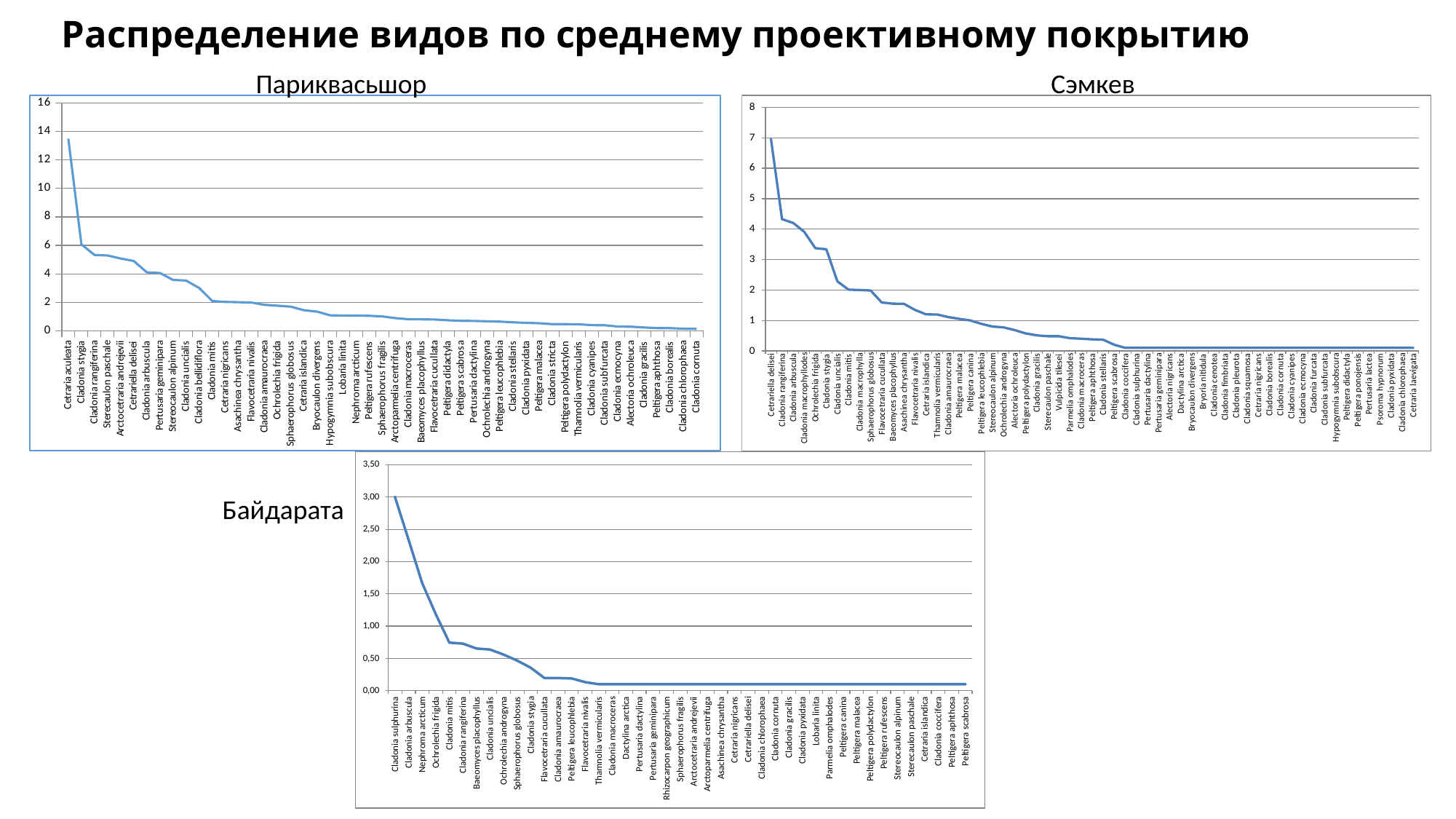
In the Париквасьшор chart, is the value for Cetraria aculeata greater or less than 12? greater In the Сэмкев chart, is the value for Cladonia arbuscula greater or less than 3? greater In the Париквасьшор chart, do the values rise or fall from left to right along the x axis? fall In the Париквасьшор chart, which species has the highest value? Cetraria aculeata In the Париквасьшор chart, is the value for Cladonia rangiferina greater or less than 4? greater How many charts are shown on the slide? 3 In the Сэмкев chart, which is larger, the value for Cetrariella delisei or the value for Cladonia rangiferina? Cetrariella delisei In the Байдарата chart, which species has the highest value? Cladonia sulphurina What kind of chart is the Париквасьшор chart? line chart In the Сэмкев chart, which species has the highest value? Cetrariella delisei